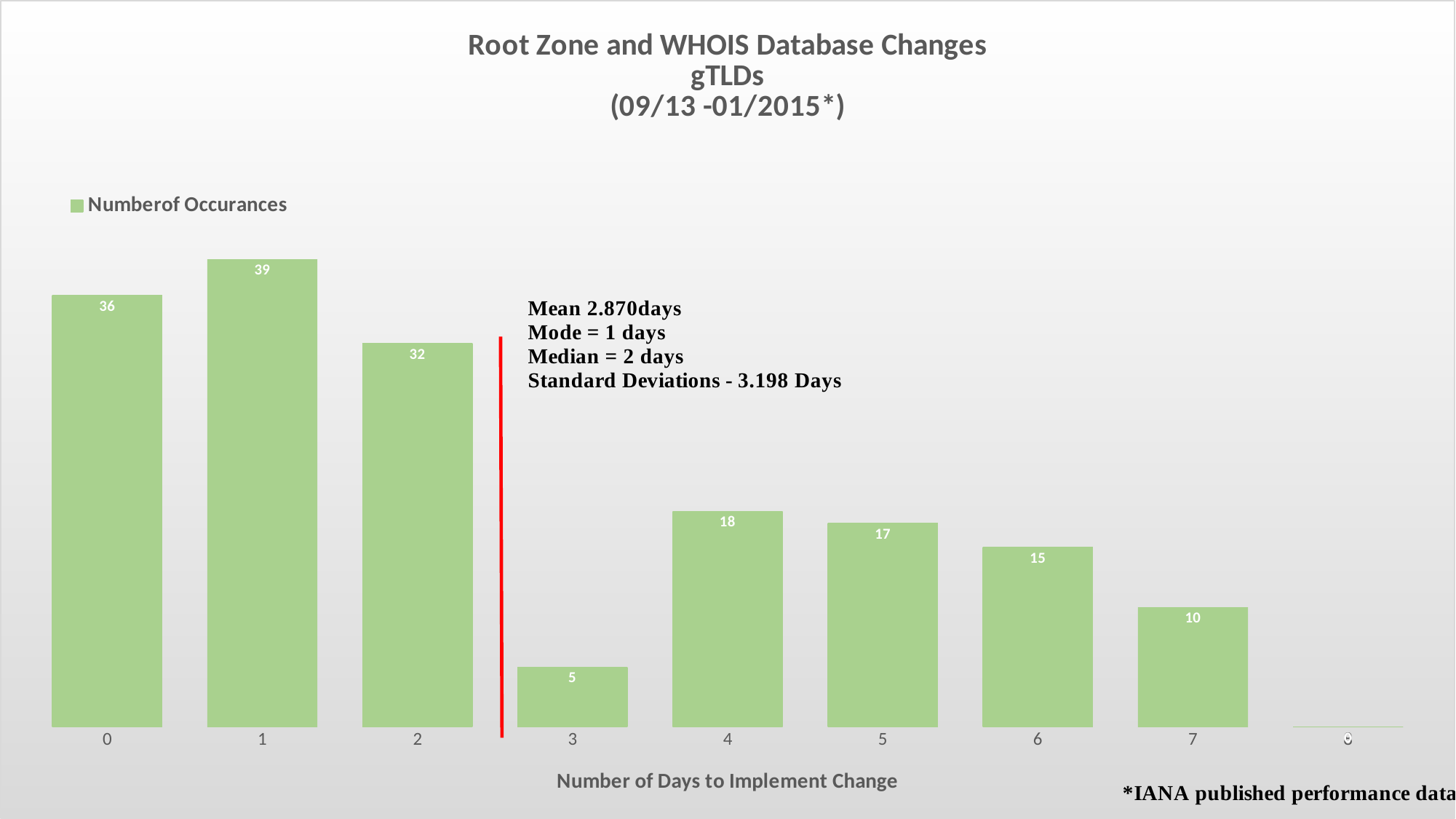
What is the difference in occurrences between 1 day and 0 days? 3 Which has more occurrences, 4 days or 5 days? 4 days What is the number of occurrences for 7 days to implement change? 10 From 4 days to 7 days, do the number of occurrences rise or fall? fall What is the title of the x axis? Number of Days to Implement Change What is the difference in occurrences between 4 days and 5 days? 1 Among days 0 through 7, which number of days has the lowest number of occurrences? 3 What is the number of occurrences for 3 days to implement change? 5 How many series does the legend list? 1 Which number of days has the highest number of occurrences? 1 What is the number of occurrences for 1 day to implement change? 39 What kind of chart is shown on the slide? bar chart